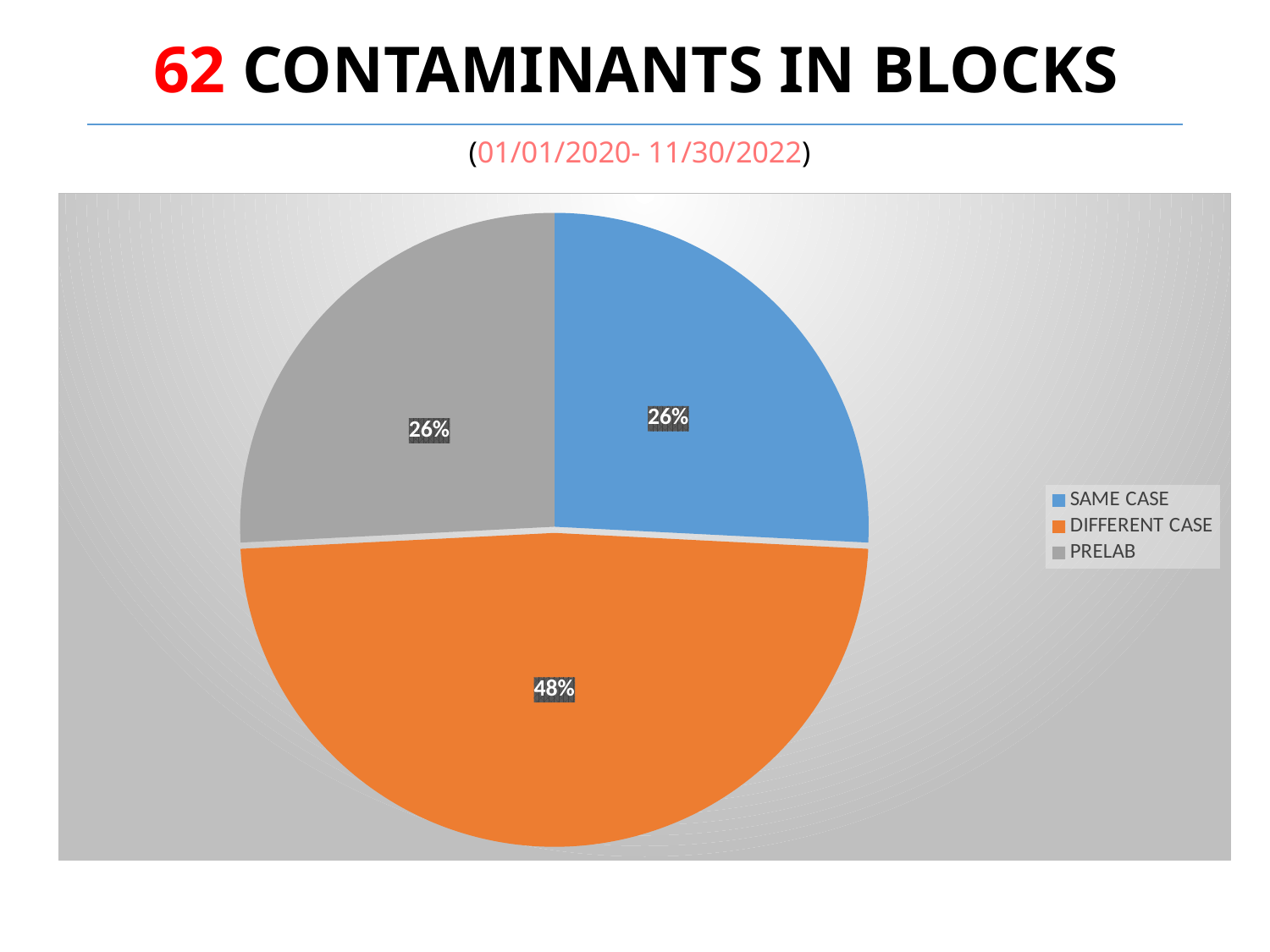
What date range is shown below the slide title? 01/01/2020- 11/30/2022 What colour is the DIFFERENT CASE slice? orange Is the share for DIFFERENT CASE greater or less than 50%? less How many categories does the pie chart show? 3 How many entries does the legend list? 3 What share of the pie does SAME CASE represent? 26% What share of the pie does DIFFERENT CASE represent? 48% Which is larger, the DIFFERENT CASE slice or the PRELAB slice? DIFFERENT CASE What share of the pie does PRELAB represent? 26% Which category has the largest slice of the pie? DIFFERENT CASE What is the difference in percentage points between the DIFFERENT CASE slice and the SAME CASE slice? 22 What kind of chart is shown on the slide? pie chart